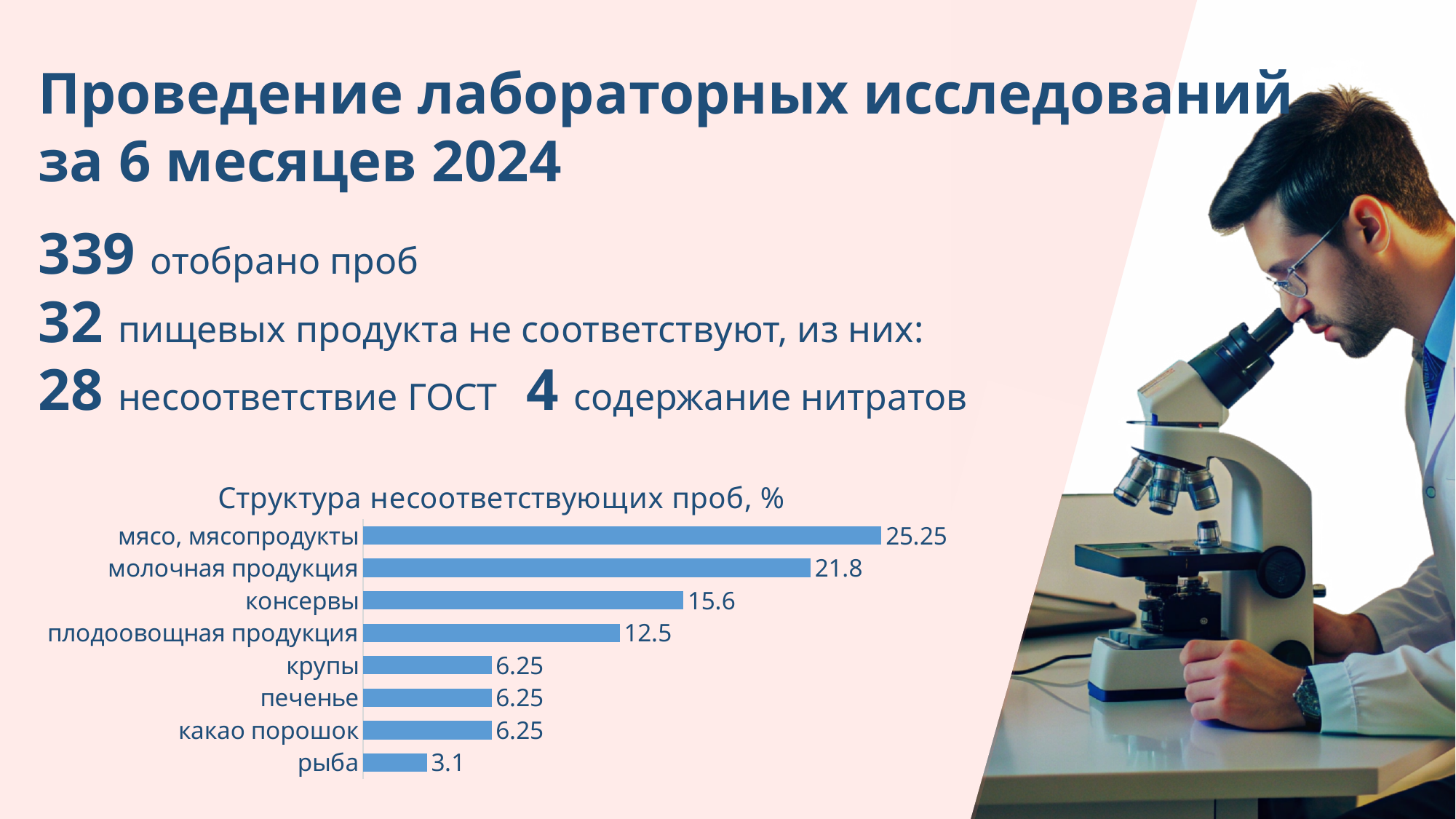
Which category has the highest value? мясо, мясопродукты What kind of chart is shown on the slide? bar chart Which category has the lowest value? рыба How many categories have a value of 6.25? 3 Which is larger, the value for молочная продукция or the value for консервы? молочная продукция What is the value for рыба? 3.1 What is the difference between the values for консервы and плодоовощная продукция? 3.1 What is the title of the chart? Структура несоответствующих проб, % How many categories are shown in the chart? 8 What is the value for консервы? 15.6 What is the value for мясо, мясопродукты? 25.25 What is the difference between the values for мясо, мясопродукты and молочная продукция? 3.45